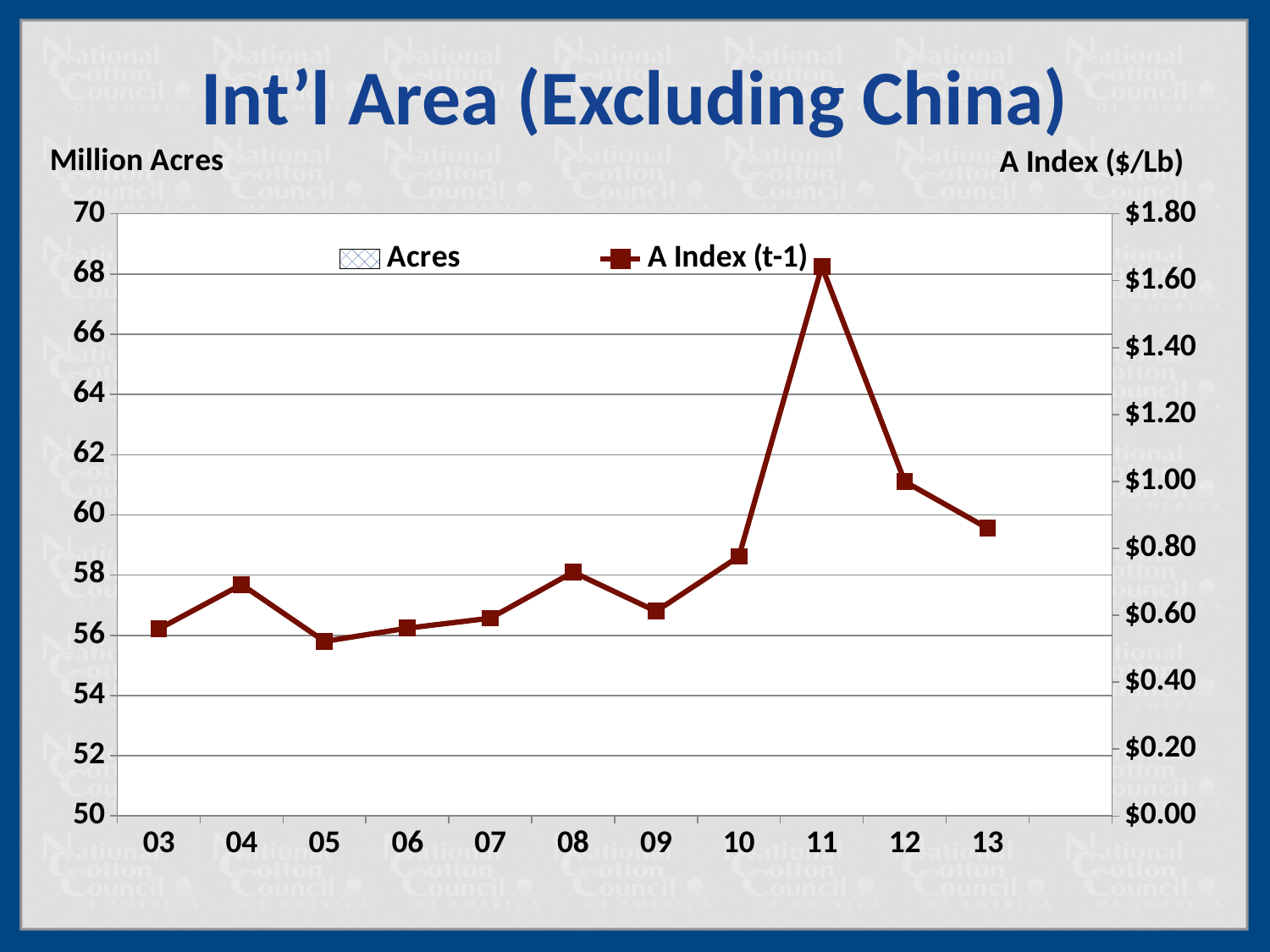
Is the A Index (t-1) value for 10 greater or less than $0.60? greater How many years are shown on the x axis? 11 What kind of chart is used to plot the A Index (t-1) series? line chart Does the A Index (t-1) rise or fall from 11 to 13? fall Which year has the larger A Index (t-1) value, 04 or 05? 04 Is the A Index (t-1) value for 13 greater or less than $1.00? less Is the A Index (t-1) value for 11 greater or less than $1.40? greater In which year is the A Index (t-1) highest? 11 How many series does the legend list? 2 What is the title of the chart? Int'l Area (Excluding China) Which year has the larger A Index (t-1) value, 11 or 12? 11